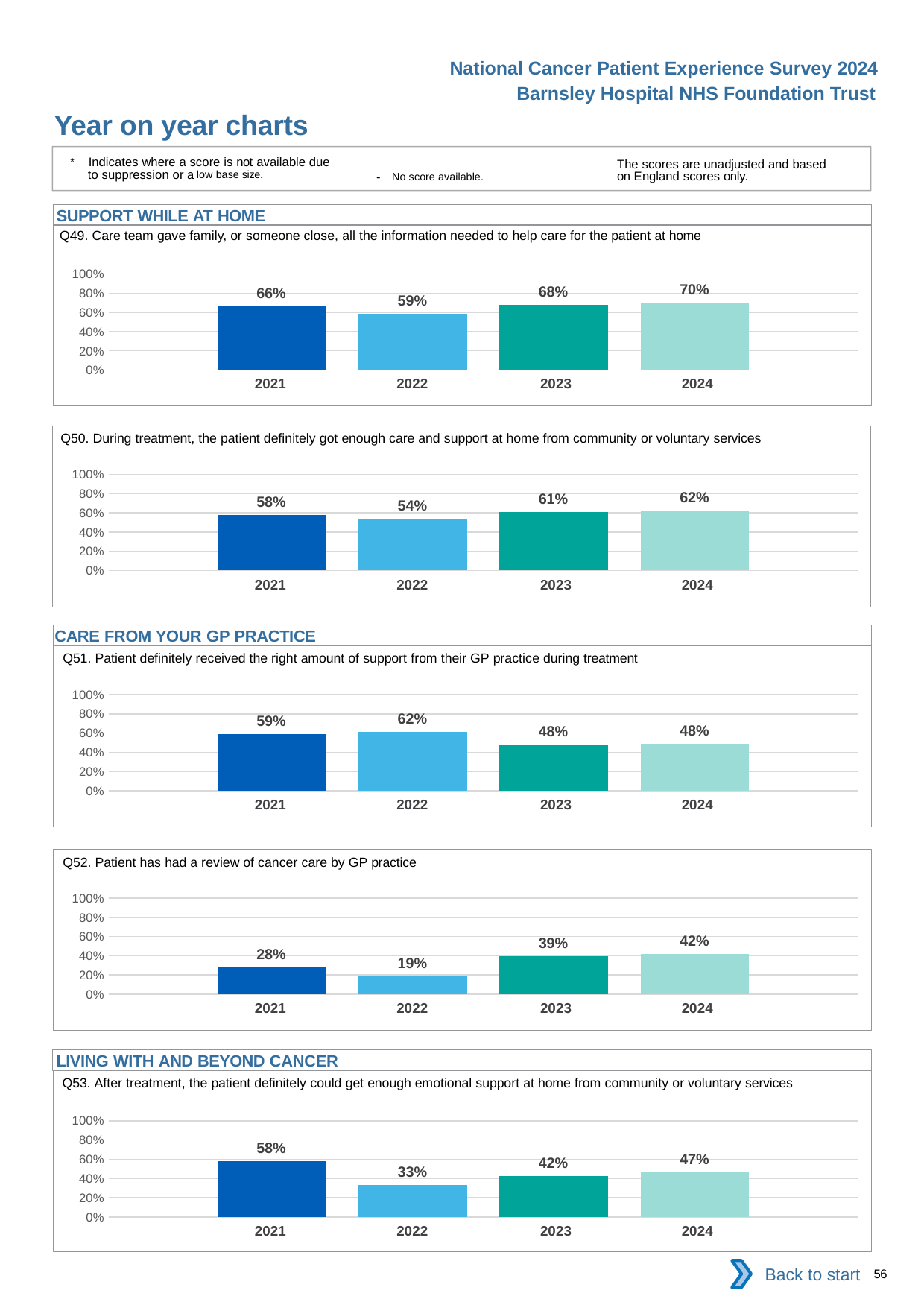
In the Q52 chart, what is the difference between the 2024 and 2021 values? 14% In the Q49 chart, which year has the lowest value? 2022 In the Q50 chart, what is the difference between the 2024 and 2022 values? 8% In the Q51 chart, is the value for 2021 larger or smaller than the value for 2023? larger In the Q53 chart, is the value for 2022 greater or less than 40%? less In the Q53 chart, which year has the highest value? 2021 In the Q52 chart, what is the value for 2022? 19% What kind of chart is the Q49 chart? bar chart How many years are shown on the x axis of the Q52 chart? 4 In the Q51 chart, what is the value for 2022? 62% In the Q50 chart, which year has the highest value? 2024 In the Q49 chart, what is the value for 2024? 70%